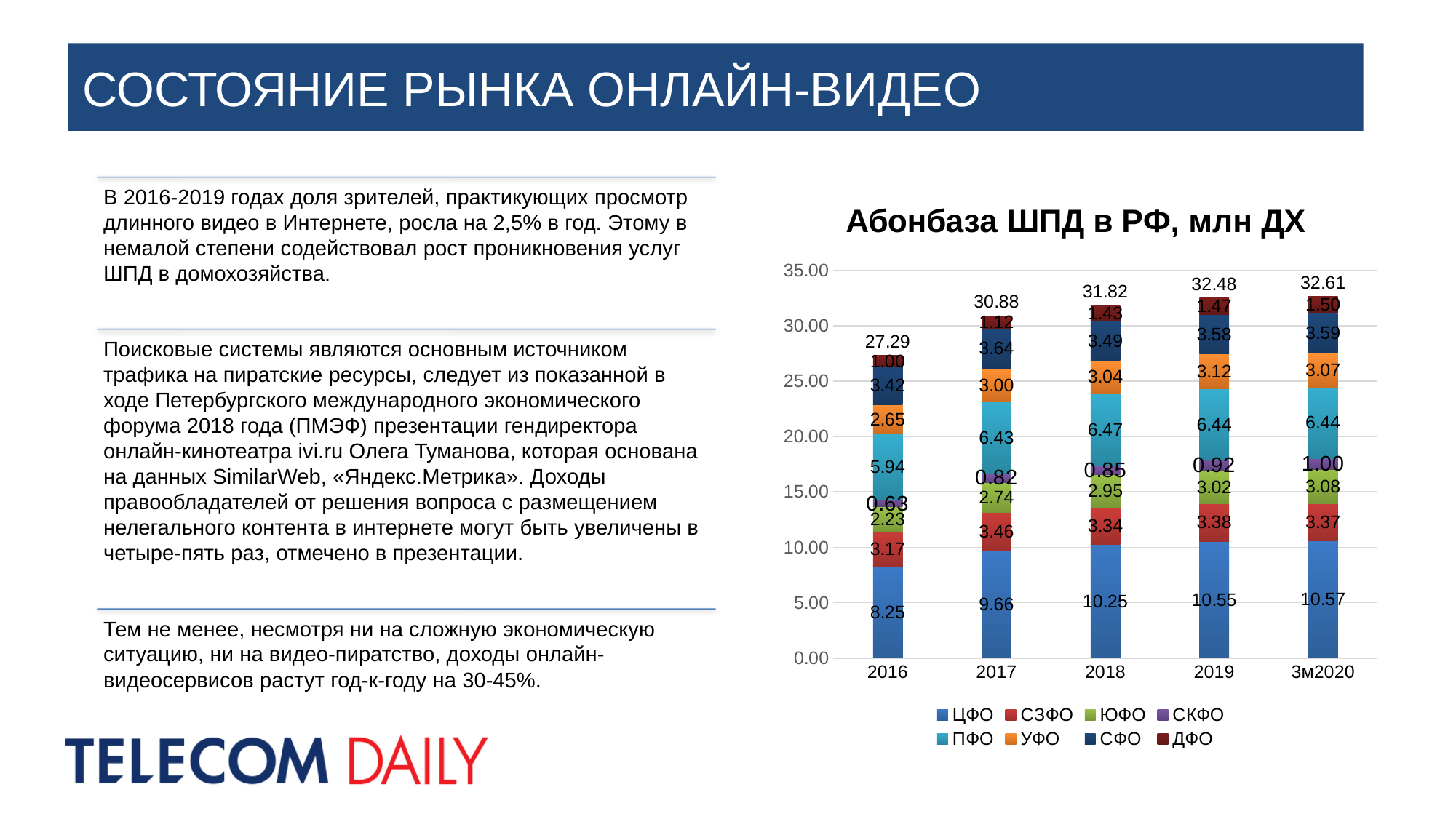
What type of chart is shown on the slide? Stacked bar chart Which category has the highest total value? 3м2020 What is the difference between the total for 2019 and the total for 2016? 5.19 What is the value for ДФО in 3м2020? 1.50 What is the value for ЦФО in 2018? 10.25 How many categories are shown on the x axis of the chart? 5 What is the title of the chart? Абонбаза ШПД в РФ, млн ДХ What is the total value of the stacked bar for 2016? 27.29 Do the total values rise or fall from 2016 to 3м2020? Rise How many series does the chart legend list? 8 Which category has the lowest total value? 2016 What is the value for ПФО in 2017? 6.43